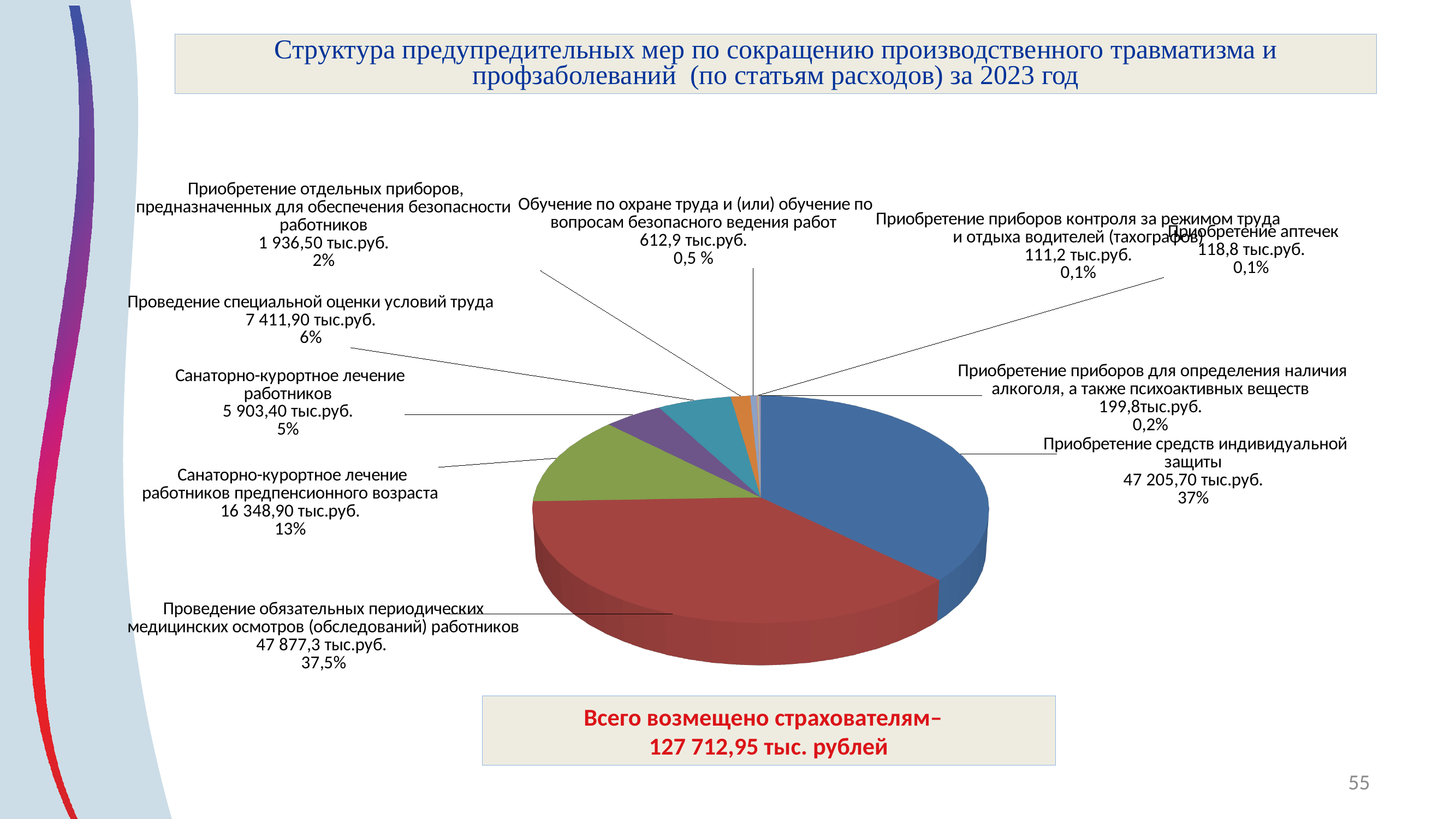
What is the value for «Обучение по охране труда и (или) обучение по вопросам безопасного ведения работ»? 612,9 тыс.руб. What share of the pie does «Проведение обязательных периодических медицинских осмотров (обследований) работников» have? 37,5% What type of chart is shown on the slide? Pie chart What is the difference between «Санаторно-курортное лечение работников предпенсионного возраста» and «Проведение специальной оценки условий труда» in тыс.руб.? 8 937,00 тыс.руб. Which is larger: «Санаторно-курортное лечение работников» or «Проведение специальной оценки условий труда»? Проведение специальной оценки условий труда What total amount reimbursed to insurers is stated below the chart? 127 712,95 тыс. рублей Which category has the largest value in the pie chart? Проведение обязательных периодических медицинских осмотров (обследований) работников What is the value for «Приобретение средств индивидуальной защиты»? 47 205,70 тыс.руб. Which category has the smallest value in the pie chart? Приобретение приборов контроля за режимом труда и отдыха водителей (тахографов) What share of the pie does «Проведение специальной оценки условий труда» have? 6% What is the value for «Санаторно-курортное лечение работников предпенсионного возраста»? 16 348,90 тыс.руб. How many categories (slices) does the pie chart show? 10